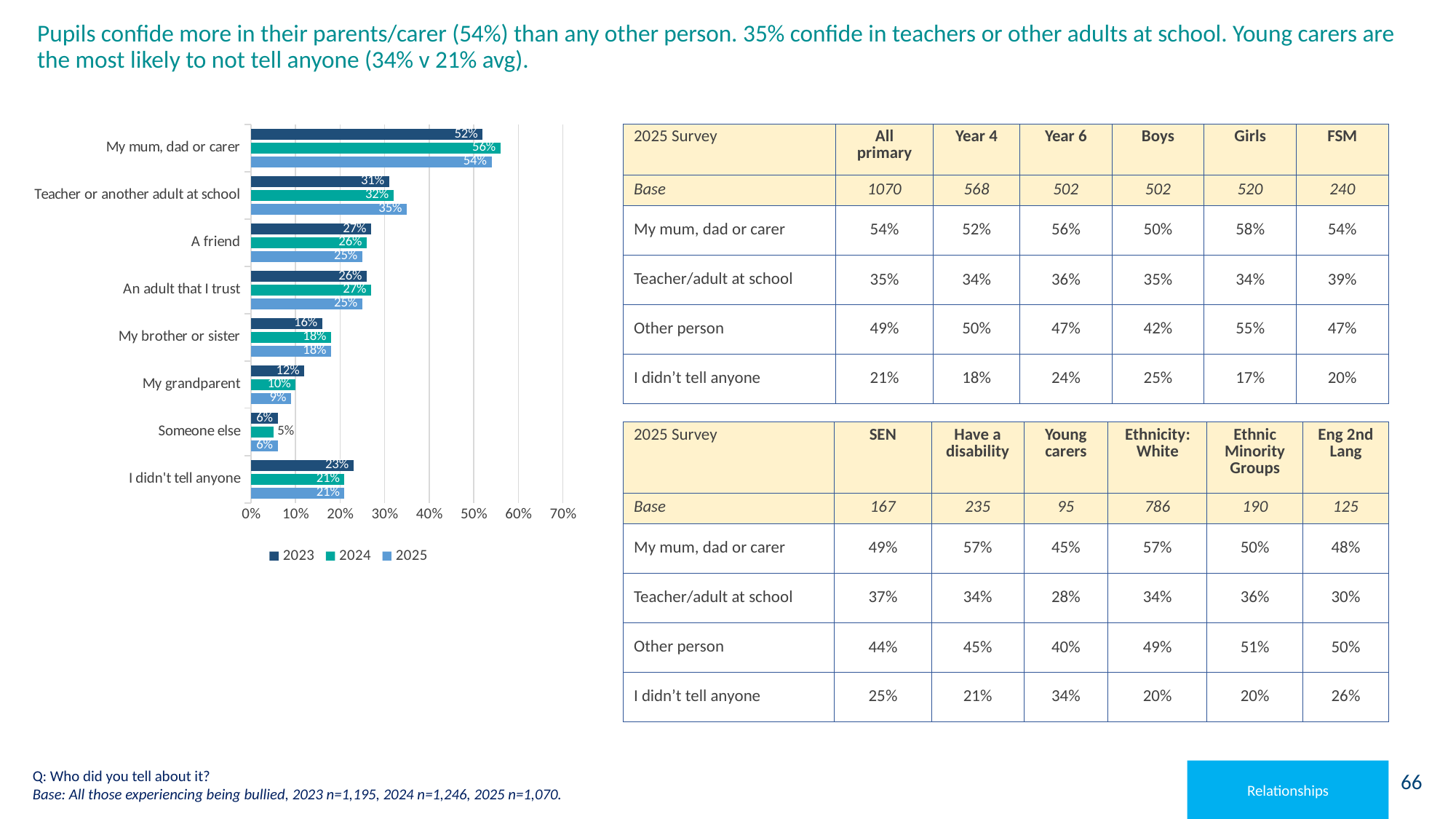
How many categories are shown in the bar chart? 8 Which category has the highest 2024 value in the bar chart? My mum, dad or carer How many series does the legend of the bar chart list? 3 What is the difference between the 2025 and 2023 values for 'Teacher or another adult at school' in the bar chart? 4% What is the 2024 value for 'My grandparent' in the bar chart? 10% What is the 2023 value for 'Teacher or another adult at school' in the bar chart? 31% Which category has the lowest 2025 value in the bar chart? Someone else What is the 2025 value for 'My mum, dad or carer' in the bar chart? 54% What kind of chart is shown on the left of the slide? bar chart What are the legend entries of the bar chart? 2023, 2024, 2025 In the bar chart, did the value for 'My grandparent' rise or fall from 2023 to 2025? fall In the bar chart, is the 2023 value for 'I didn't tell anyone' larger or smaller than the 2025 value? larger